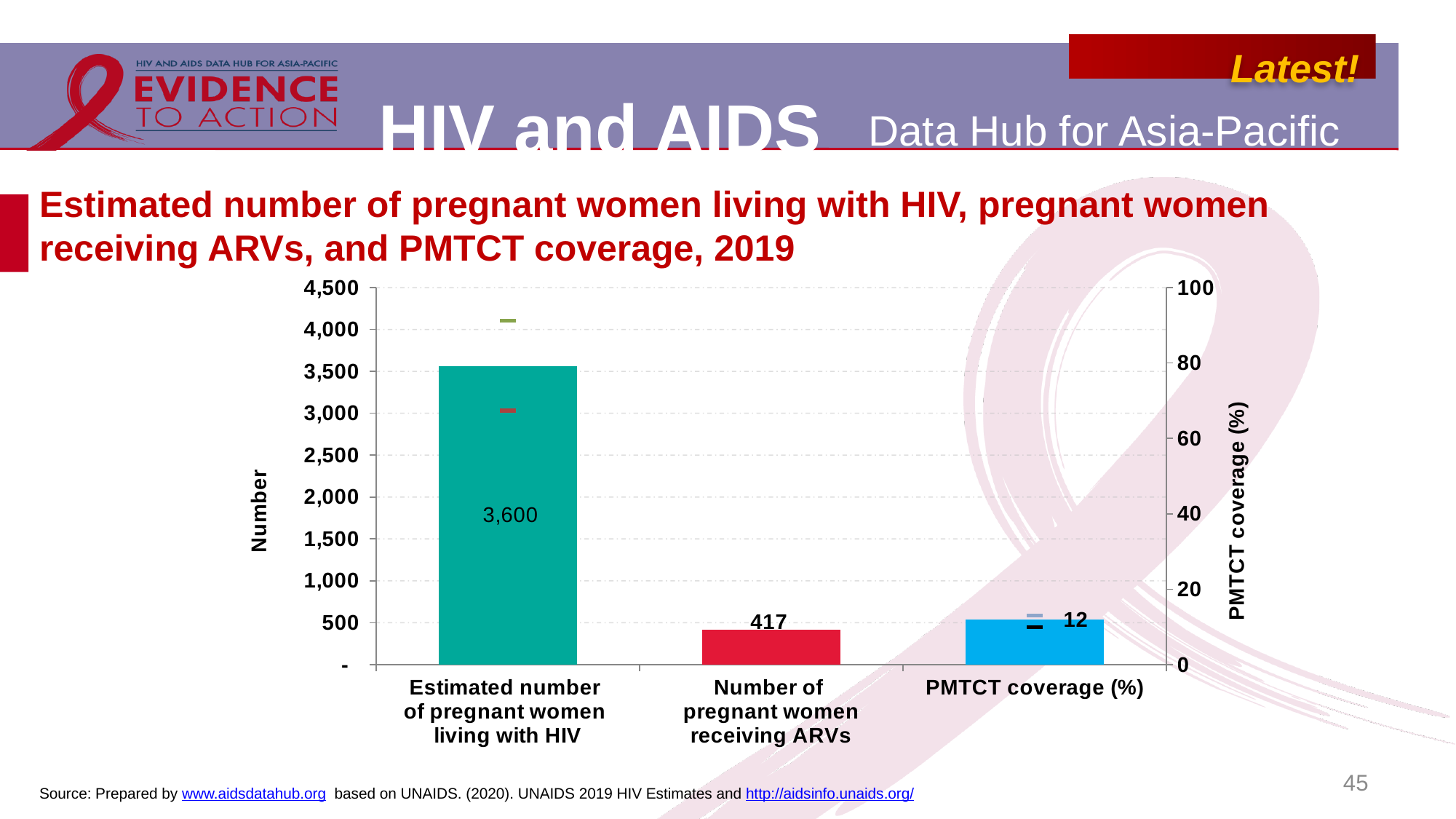
What is the title of the left vertical axis of the chart? Number How many bars are plotted on the chart? 3 Which is larger: the estimated number of pregnant women living with HIV or the number of pregnant women receiving ARVs? Estimated number of pregnant women living with HIV What is the estimated number of pregnant women living with HIV shown on the chart? 3,600 What is the number of pregnant women receiving ARVs shown on the chart? 417 Which category has the tallest bar on the chart? Estimated number of pregnant women living with HIV Is the value for the number of pregnant women receiving ARVs greater or less than 500 on the left axis? less What type of chart is shown on the slide? Bar chart What is the title of the right vertical axis of the chart? PMTCT coverage (%) What is the PMTCT coverage (%) value shown on the chart? 12 What is the difference between the estimated number of pregnant women living with HIV and the number of pregnant women receiving ARVs? 3,183